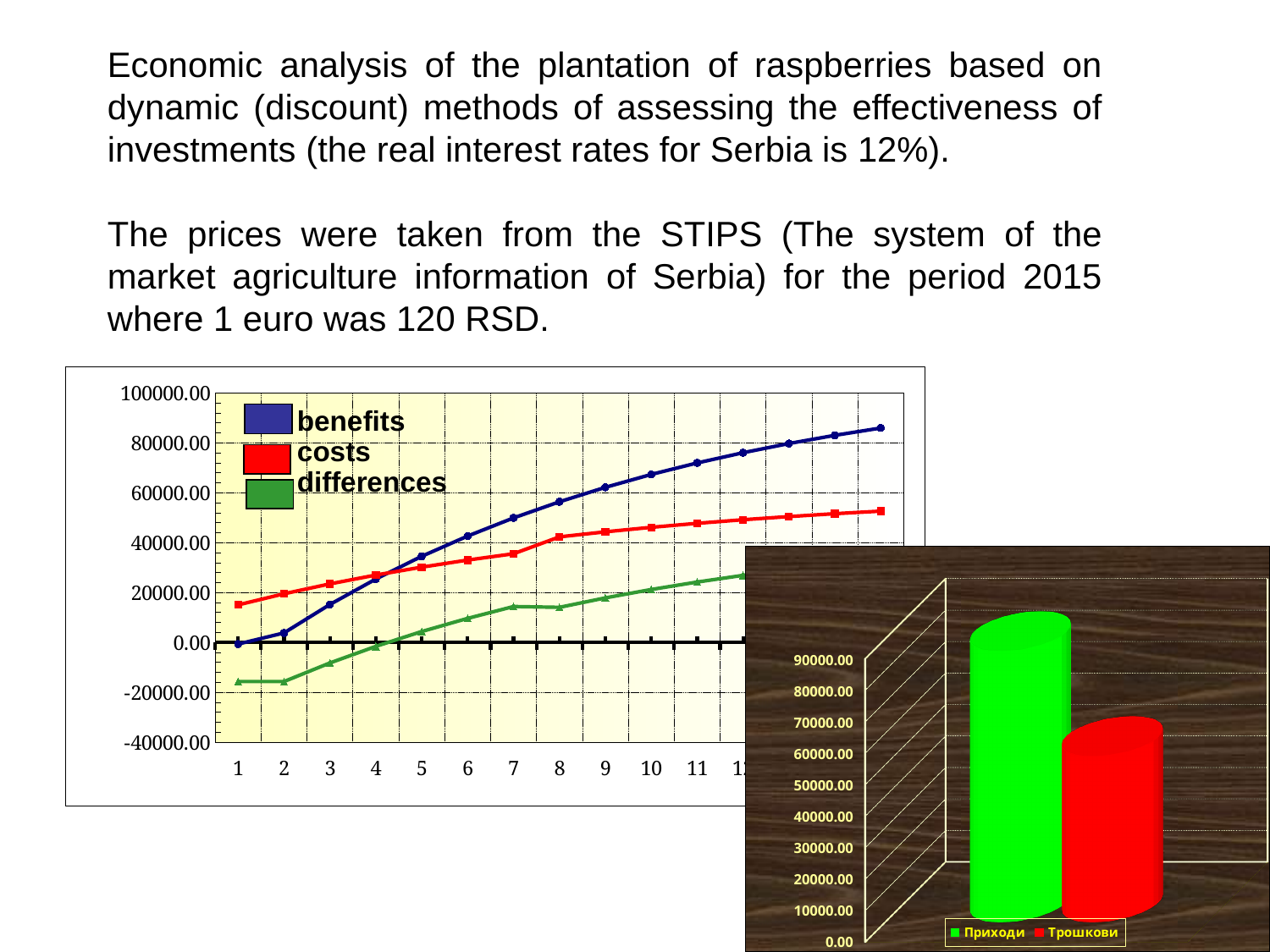
On the line chart on the left, which is larger at point 12: benefits or costs? benefits On the line chart on the left, how many series does the legend list? 3 On the line chart on the left, what are the names of the series in the legend? benefits, costs, differences On the line chart on the left, which is larger at point 1: benefits or costs? costs On the bar chart in the bottom right, which bar is taller: Приходи or Трошкови? Приходи On the line chart on the left, is the costs value at point 1 greater or less than 20000.00? less On the line chart on the left, do the benefits values rise or fall as the x axis goes from 1 to 12? rise On the line chart on the left, is the costs value at point 12 greater or less than 60000.00? less What kind of chart is the chart on the left of the slide? line chart On the line chart on the left, is the benefits value at point 12 greater or less than 80000.00? less What kind of chart is the chart in the bottom right of the slide? bar chart